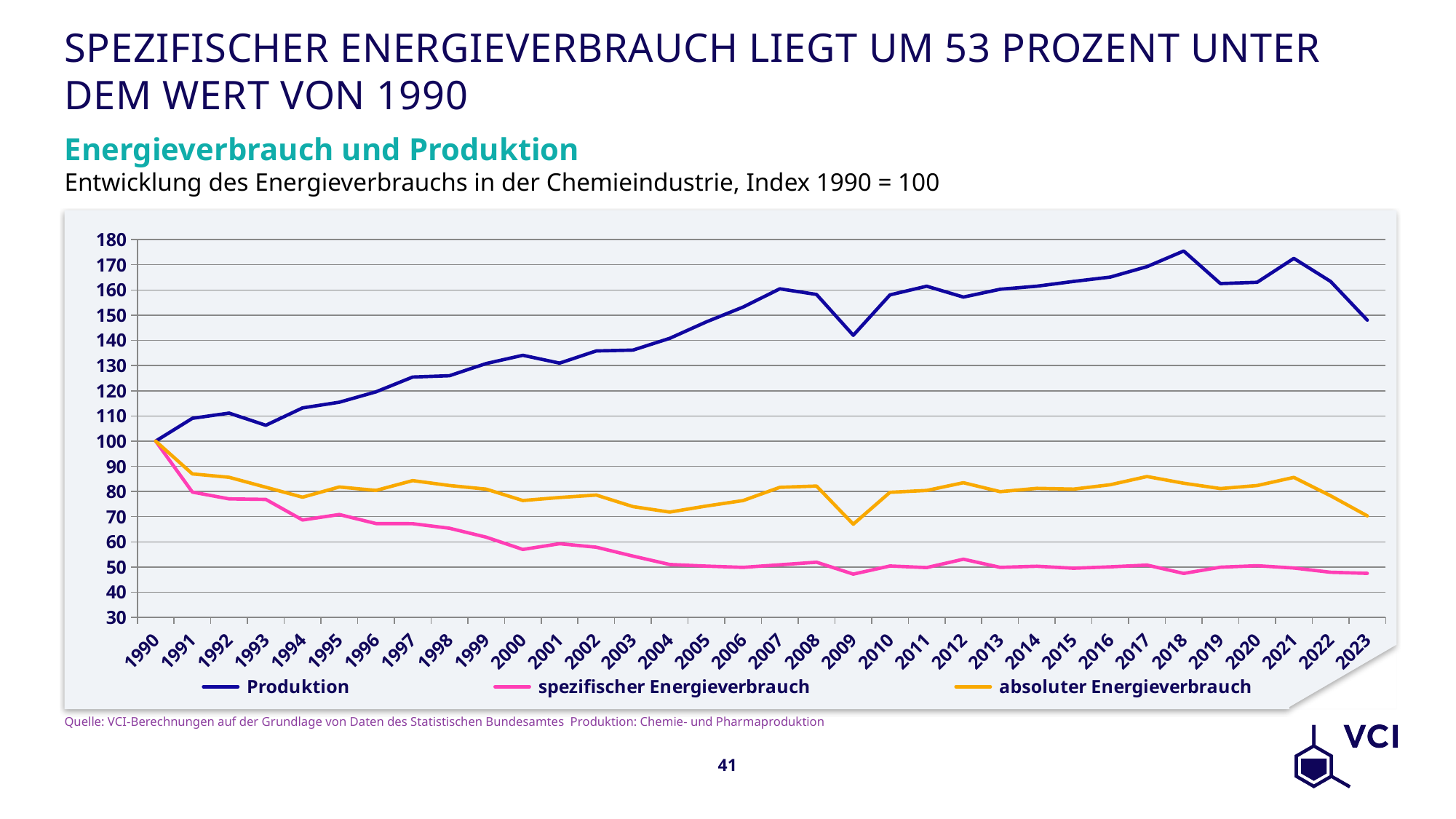
Is the value for Produktion in 2009 greater or less than 150? less In which year does Produktion reach its highest value? 2018 What is the value of Produktion in 1990? 100 What kind of chart is shown on the slide? line chart How many series does the legend list? 3 Is the value for spezifischer Energieverbrauch in 2023 greater or less than 50? less Does spezifischer Energieverbrauch rise or fall overall from 1990 to 2023? fall Which is larger in 2023: absoluter Energieverbrauch or spezifischer Energieverbrauch? absoluter Energieverbrauch Is the value for absoluter Energieverbrauch in 2017 greater or less than 80? greater How many years are plotted along the x axis? 34 In which year is spezifischer Energieverbrauch at its highest? 1990